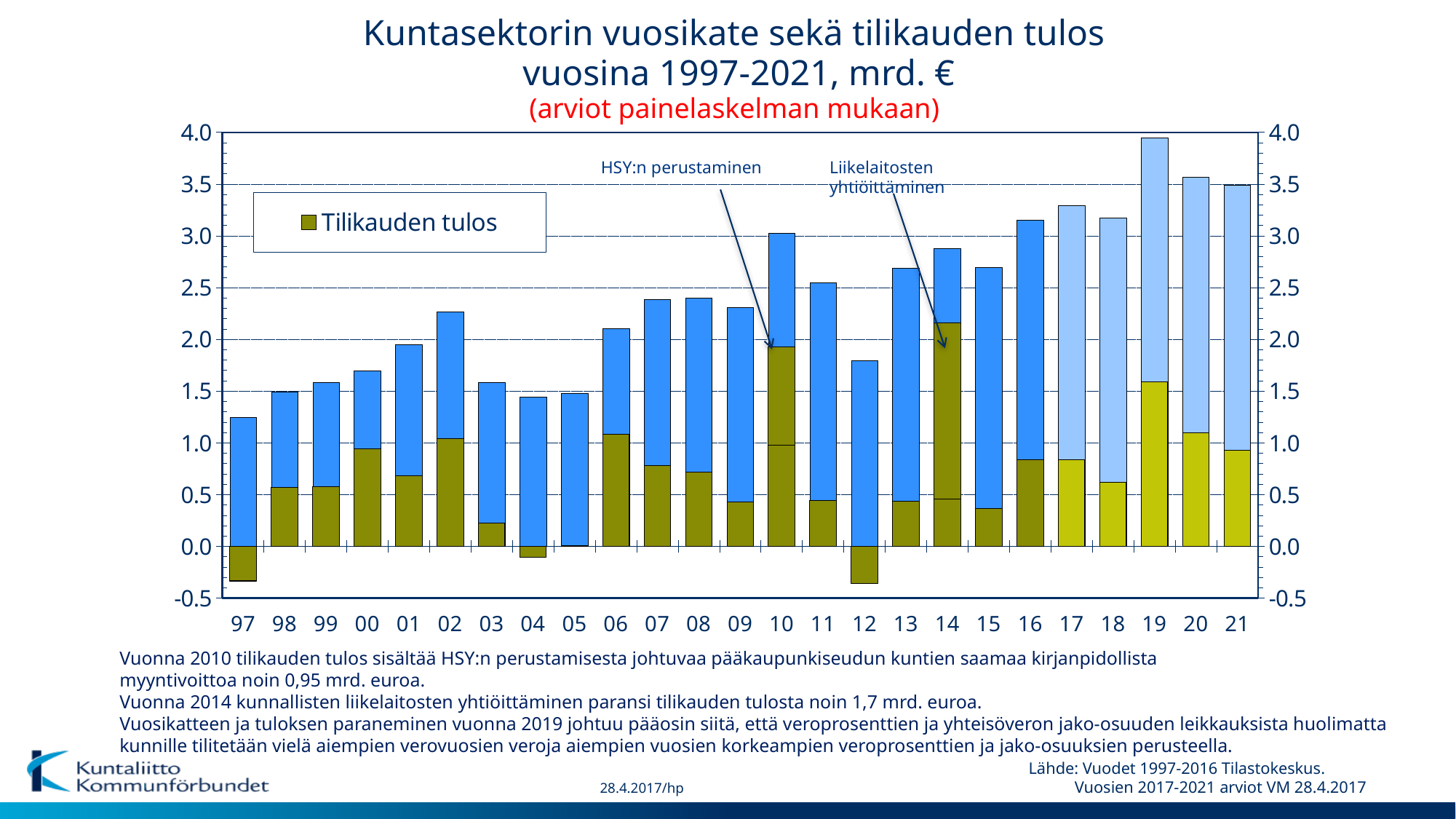
How many series does the chart's legend list? 1 Is the Tilikauden tulos value for 03 greater or less than 0.5? less What series name is shown in the chart's legend? Tilikauden tulos In which year is the Tilikauden tulos bar the highest? 14 Which year has the larger Tilikauden tulos bar, 10 or 14? 14 Is the Tilikauden tulos value for 12 greater or less than 0.0? less What kind of chart is shown on the slide? bar chart In which year is the tall blue bar (vuosikate) the lowest? 97 In which year is the tall blue bar (vuosikate) the highest? 19 Which year has the larger vuosikate bar, 12 or 13? 13 How many years are shown along the x axis of the chart? 25 Is the vuosikate value for 19 greater or less than 3.5? greater